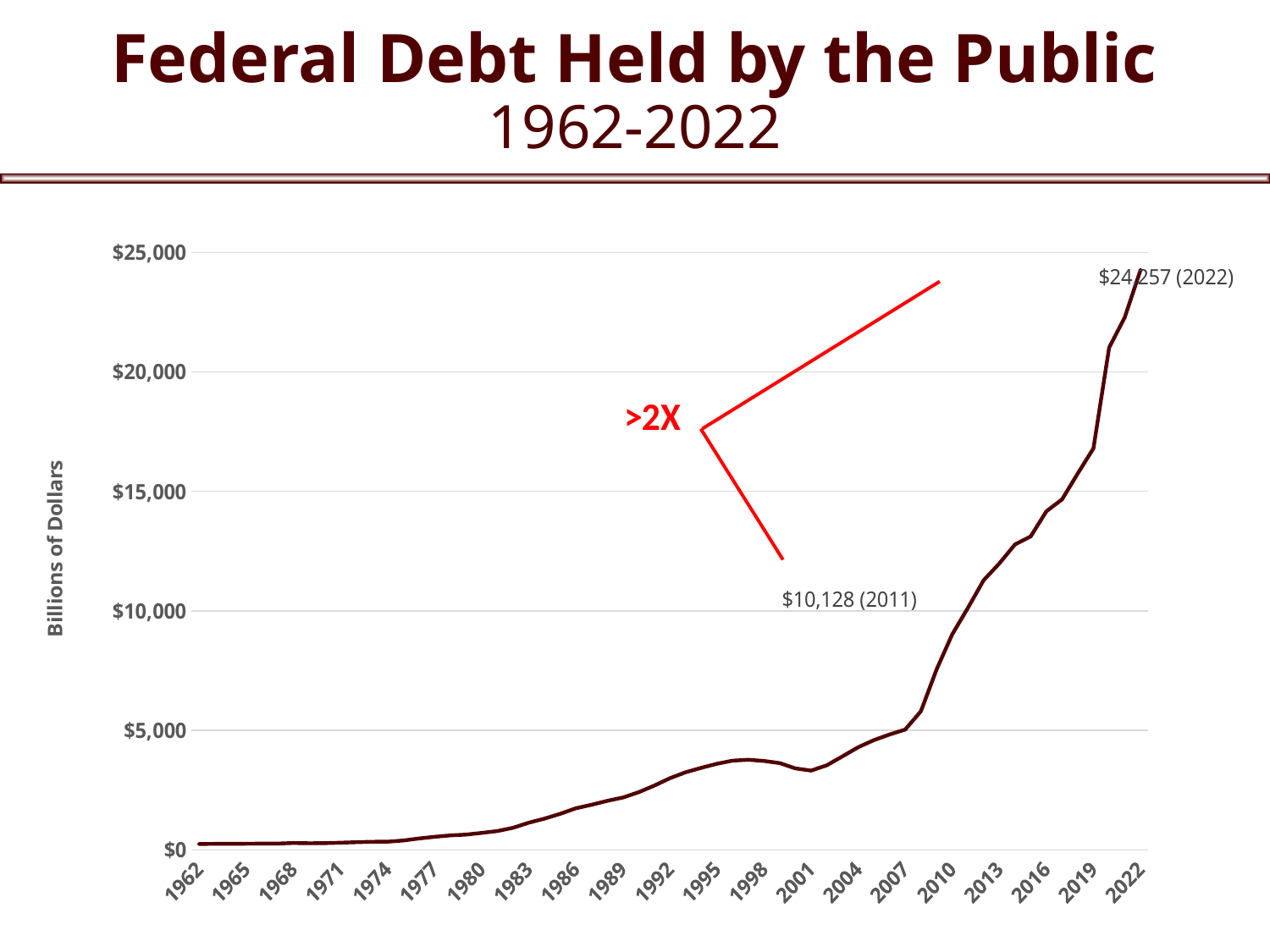
Is the value for 2013 greater or less than $10,000? greater What is the value of federal debt held by the public in 2022? $24,257 Is the value for 2004 greater or less than $5,000? less Overall, do the values rise or fall from 1962 to 2022? rise Which year has the highest federal debt held by the public? 2022 What kind of chart is shown on the slide? line chart What text does the red annotation between the two labelled points show? >2X What is the difference between the 2022 value and the 2011 value? $14,129 Which is larger, the value for 2011 or the value for 2022? 2022 What is the value of federal debt held by the public in 2011? $10,128 What is the title of the y axis? Billions of Dollars Is the value for 2019 greater or less than $15,000? greater